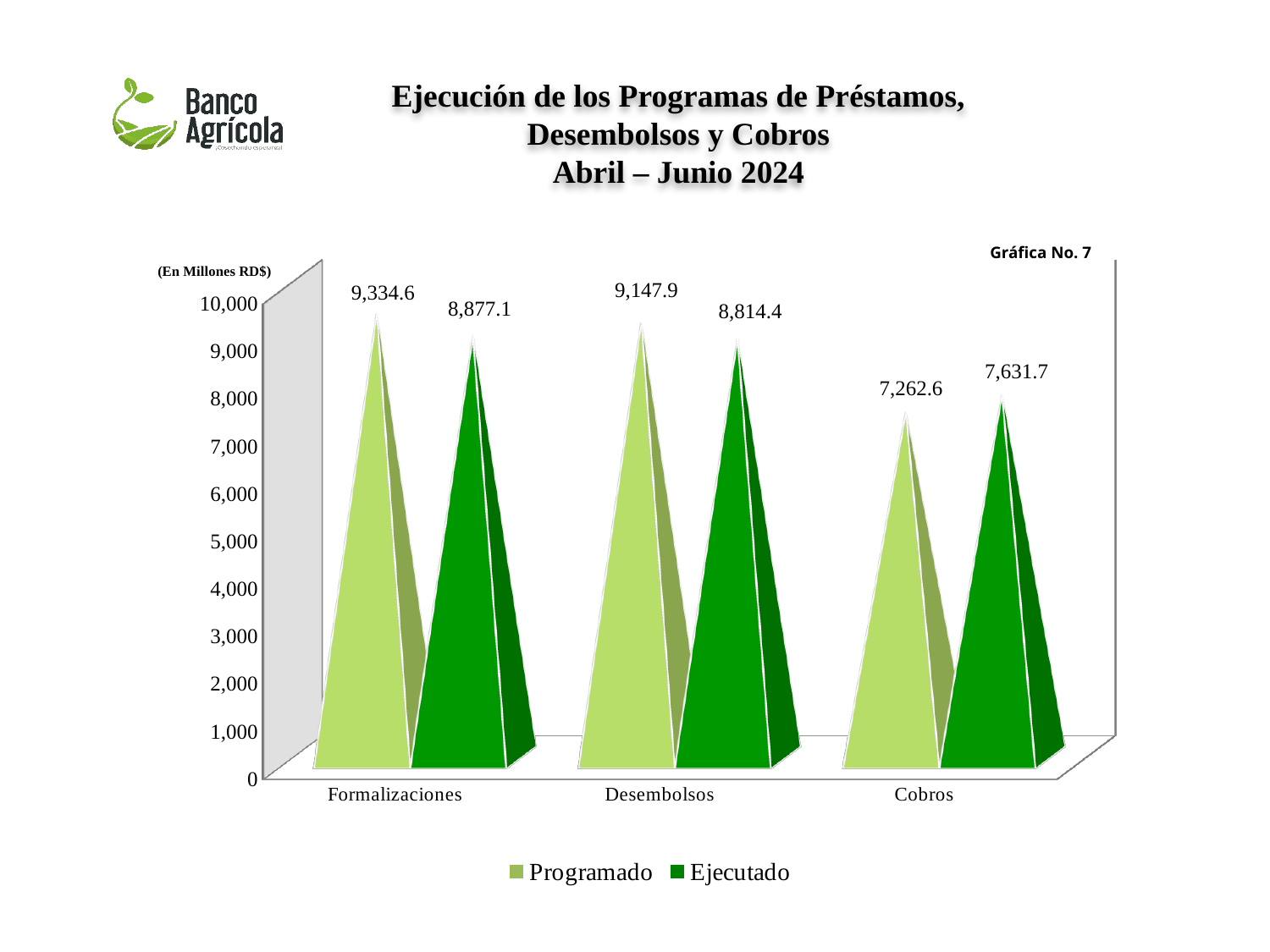
How many categories are shown on the x axis? 3 Which category has the lowest Ejecutado value? Cobros What is the difference between the Programado and Ejecutado values for Formalizaciones? 457.5 What unit is stated for the values in the chart? En Millones RD$ What is the Ejecutado value for Cobros? 7,631.7 How many series does the legend list? 2 Which category has the highest Programado value? Formalizaciones What is the Ejecutado value for Desembolsos? 8,814.4 What is the Programado value for Cobros? 7,262.6 For Cobros, which is larger: Programado or Ejecutado? Ejecutado What is the difference between the Ejecutado and Programado values for Cobros? 369.1 What is the Programado value for Formalizaciones? 9,334.6